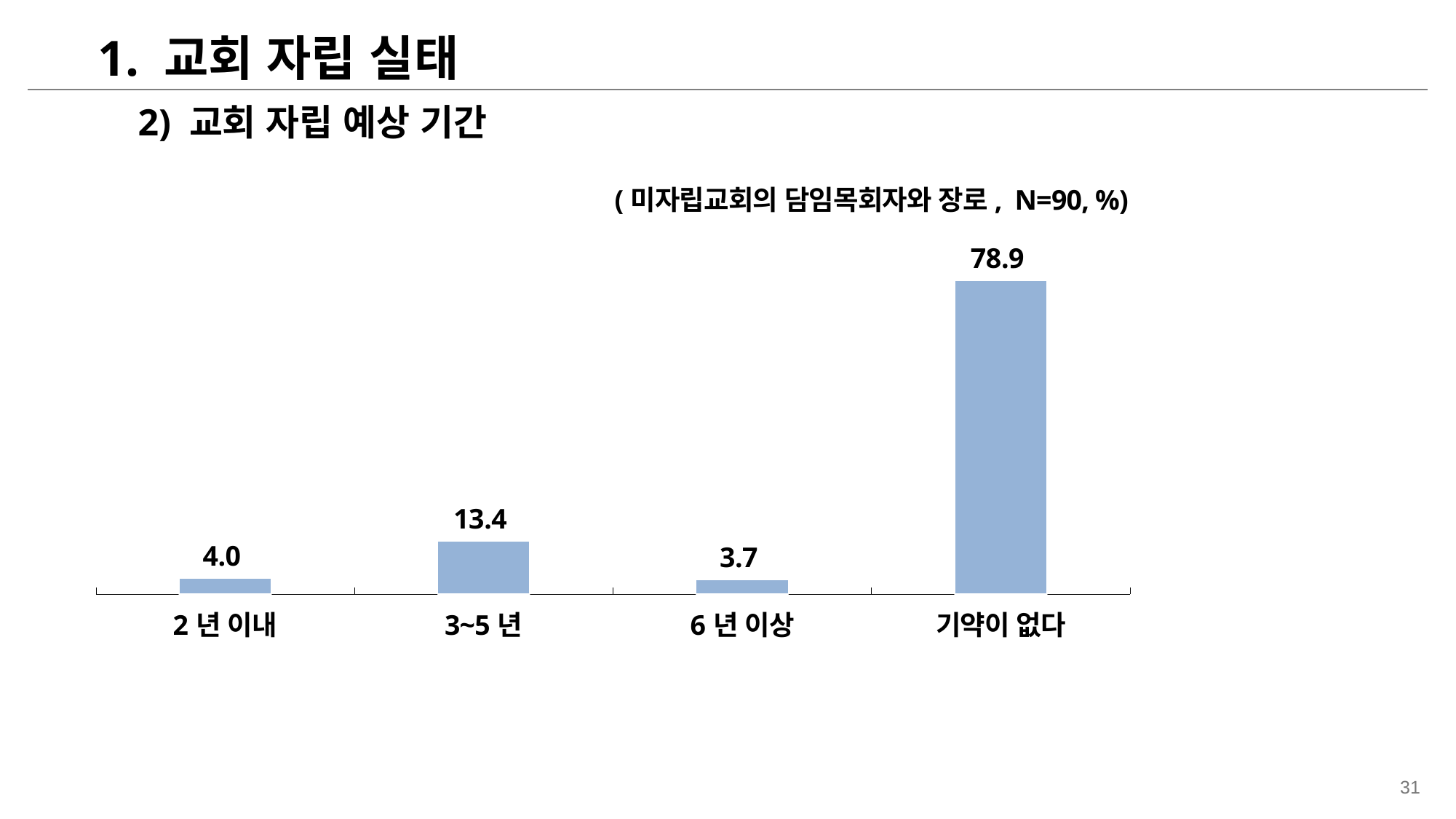
What is the value for 6 년 이상? 3.7 What is the value for 기약이 없다? 78.9 What is the value for 3~5 년? 13.4 What sample size (N) is stated in the chart's note? N=90 What is the difference between the values for 3~5 년 and 2 년 이내? 9.4 Which is larger, the value for 2 년 이내 or the value for 6 년 이상? 2 년 이내 What kind of chart is shown on the slide? bar chart How many categories are shown in the chart? 4 What is the value for 2 년 이내? 4.0 Which category has the lowest value? 6 년 이상 What is the difference between the values for 기약이 없다 and 3~5 년? 65.5 Which category has the highest value? 기약이 없다